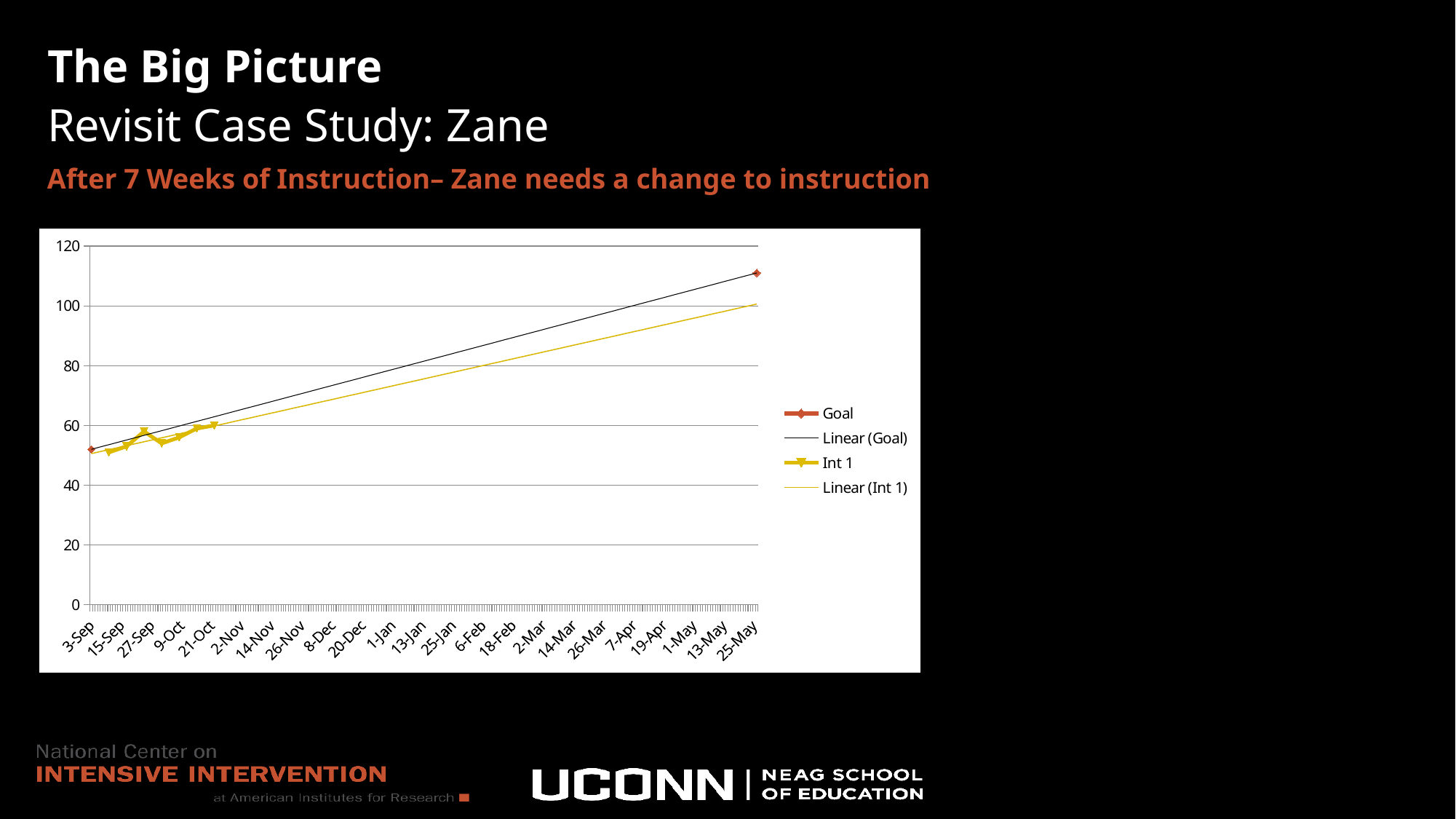
Is the value of the Goal series at 25-May greater or less than 100? greater Is the value of the Goal series at 3-Sep greater or less than 60? less Is the value of the Goal series at 3-Sep greater or less than 40? greater What colour is the Int 1 series line? yellow Do the Int 1 values generally rise or fall from 3-Sep to 21-Oct? rise What are the four entries in the chart legend? Goal, Linear (Goal), Int 1, Linear (Int 1) What kind of chart is shown on the slide? line chart How many series does the chart legend list? 4 Which is larger: the Goal value at 25-May or the last Int 1 value around 21-Oct? Goal value at 25-May Does the Linear (Goal) trendline rise or fall from 3-Sep to 25-May? rise